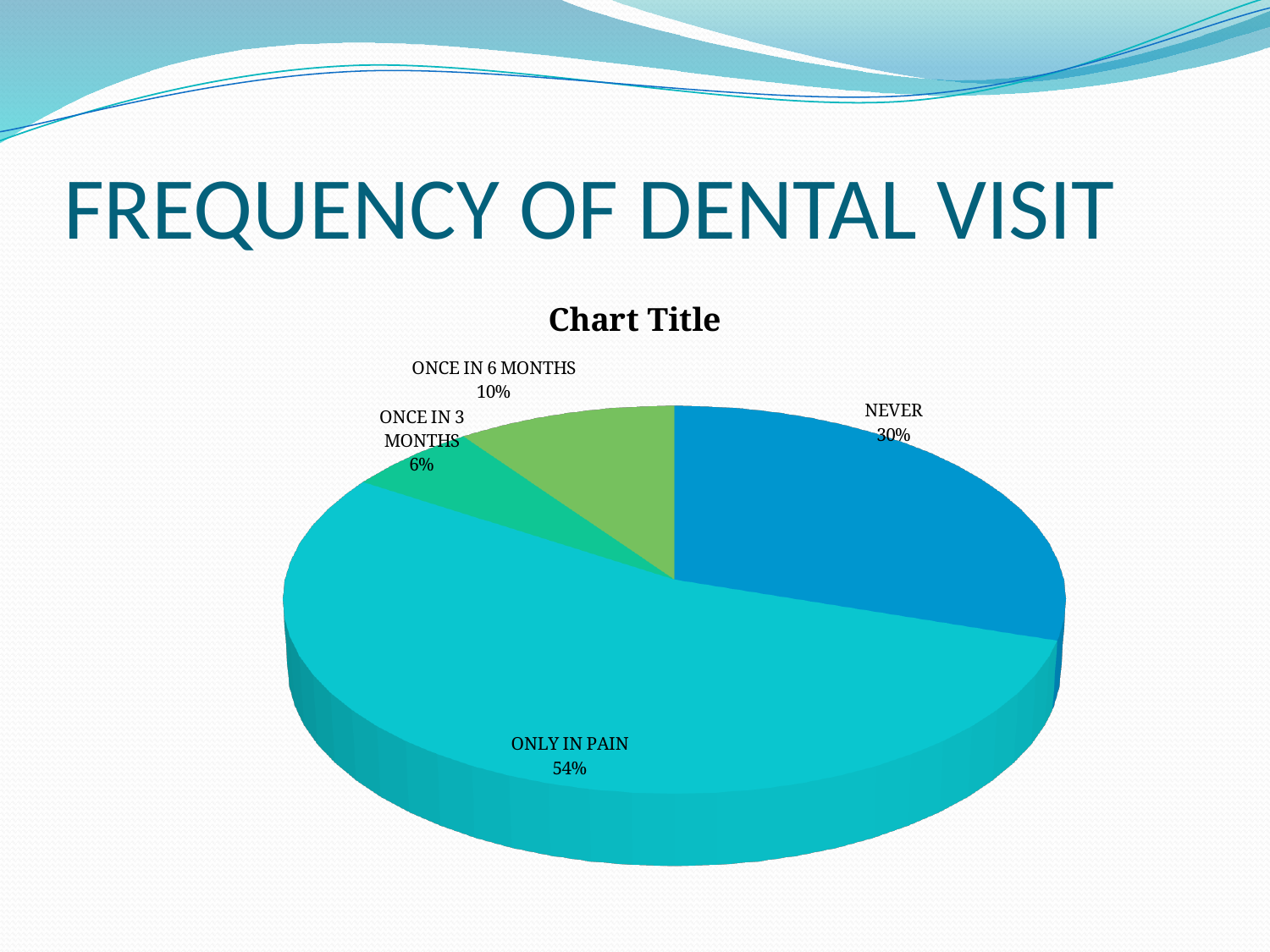
What kind of chart is shown on the slide? Pie chart Which category has the largest slice of the pie? ONLY IN PAIN What percentage of the pie is labelled NEVER? 30% What is the difference in percentage points between ONCE IN 6 MONTHS and ONCE IN 3 MONTHS? 4 What is the title printed above the chart? Chart Title What percentage of the pie is labelled ONLY IN PAIN? 54% Which category has the smallest slice of the pie? ONCE IN 3 MONTHS Which is larger, the NEVER slice or the ONCE IN 6 MONTHS slice? NEVER What percentage of the pie is labelled ONCE IN 3 MONTHS? 6% What is the difference in percentage points between ONLY IN PAIN and NEVER? 24 How many slices does the pie chart have? 4 What percentage of the pie is labelled ONCE IN 6 MONTHS? 10%